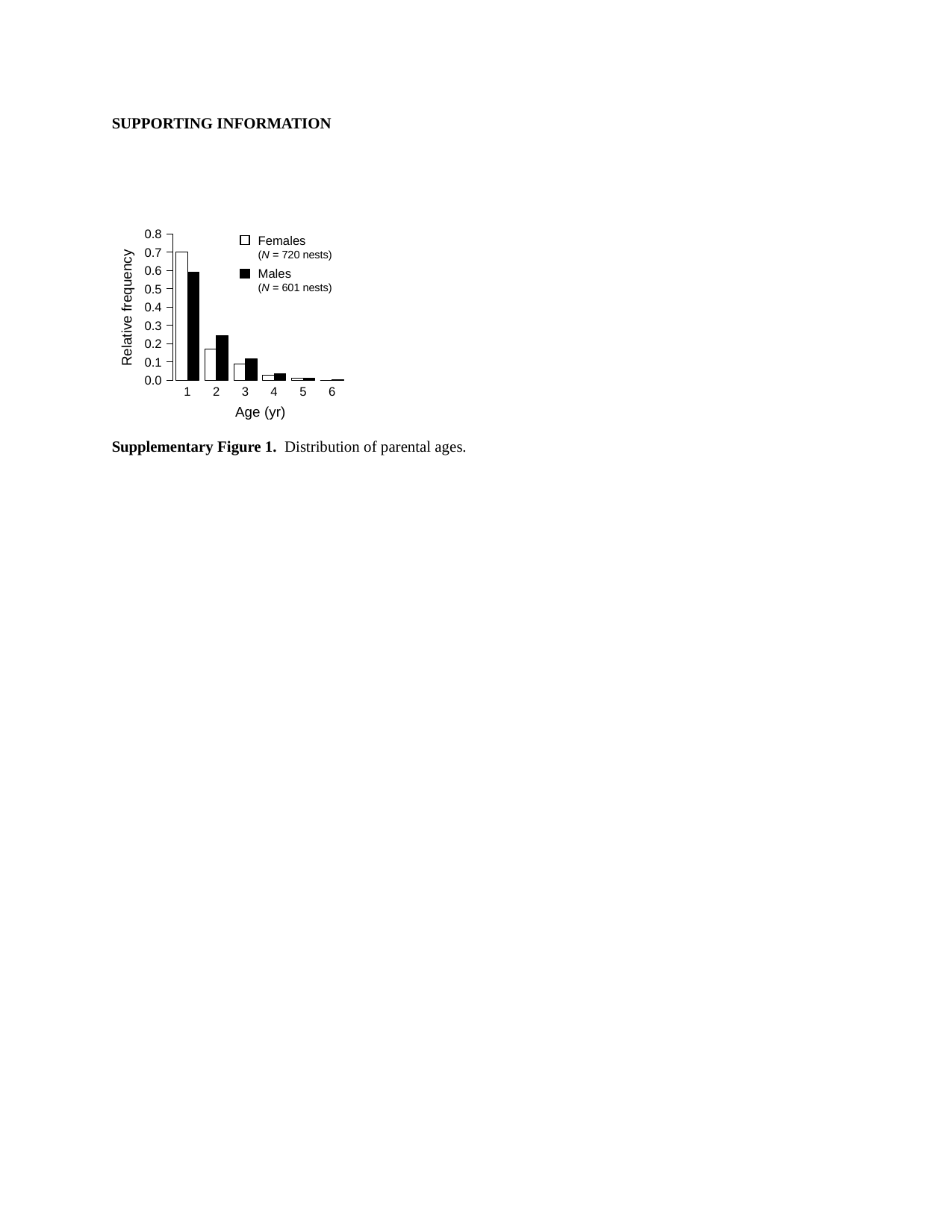
At age 2, which series has the larger relative frequency, Females or Males? Males Is the relative frequency for Males at age 1 greater or less than 0.5? greater Which age has the highest relative frequency for Females? 1 Do the relative frequencies for Females rise or fall as age increases from 1 to 6? fall At age 1, which series has the larger relative frequency, Females or Males? Females Is the relative frequency for Females at age 1 greater or less than 0.6? greater How many series does the chart's legend list? 2 What is the label of the y axis? Relative frequency How many age categories are shown on the x axis? 6 Is the relative frequency for Males at age 2 greater or less than 0.3? less Which age has the highest relative frequency for Males? 1 What kind of chart is shown on the slide? bar chart